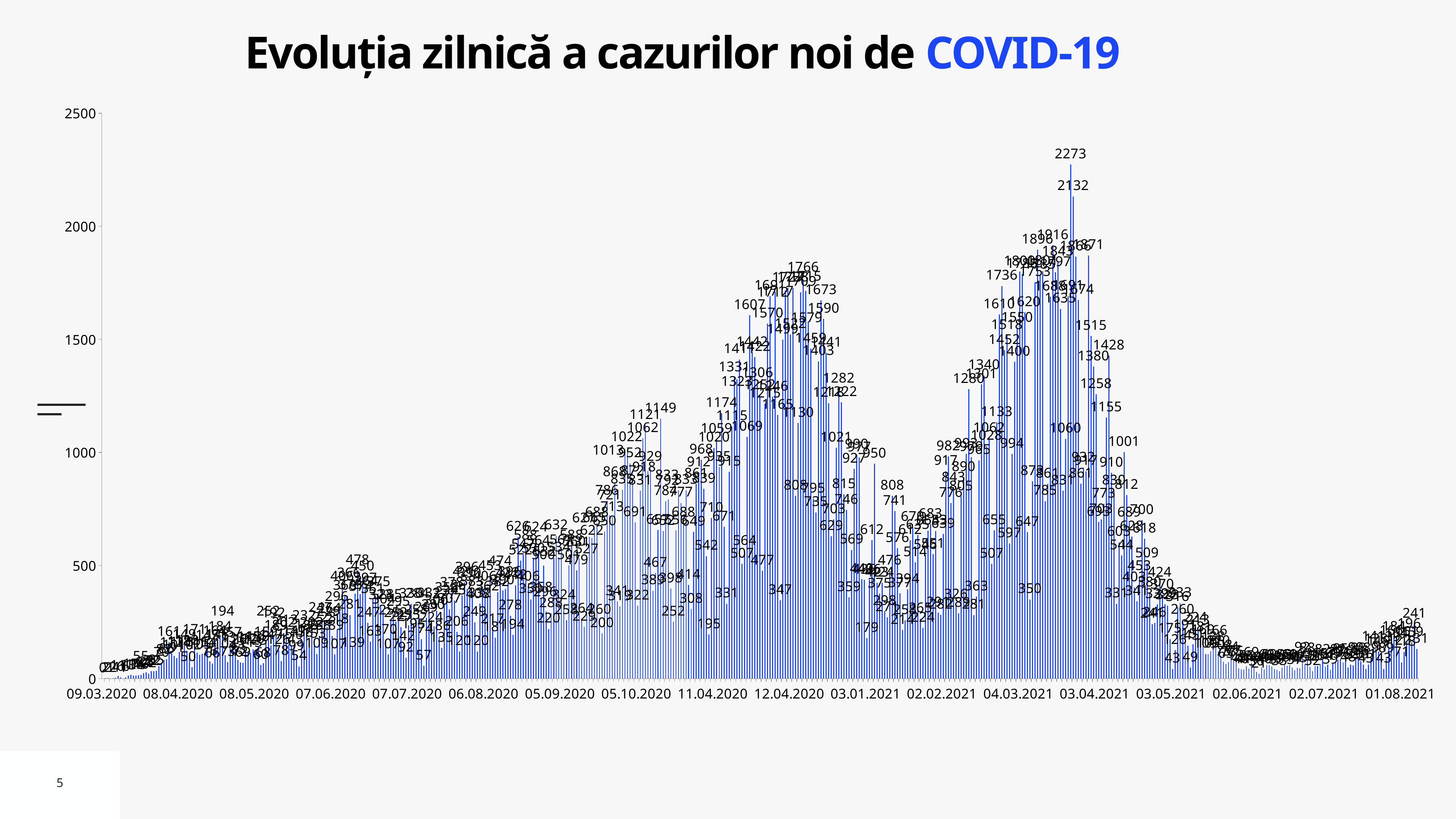
What is the highest daily value labelled on the chart? 2273 Which is larger: the peak near 03.04.2021 (2273) or the peak near 12.04.2020 (1766)? 2273 (near 03.04.2021) Near which x-axis date label does the highest peak (2273) occur? 03.04.2021 Is the highest bar on the chart greater or less than 2000? greater What is the difference between the two highest labelled values, 2273 and 2132? 141 What kind of chart is shown on the slide? bar chart Are the daily values around 02.06.2021 greater or less than 500? less What is the second highest value labelled on the chart, next to the 2273 peak? 2132 What is the first date label on the x axis? 09.03.2020 What is the maximum value shown on the y axis? 2500 How many date labels are shown on the x axis? 18 What is the title of the chart? Evoluția zilnică a cazurilor noi de COVID-19